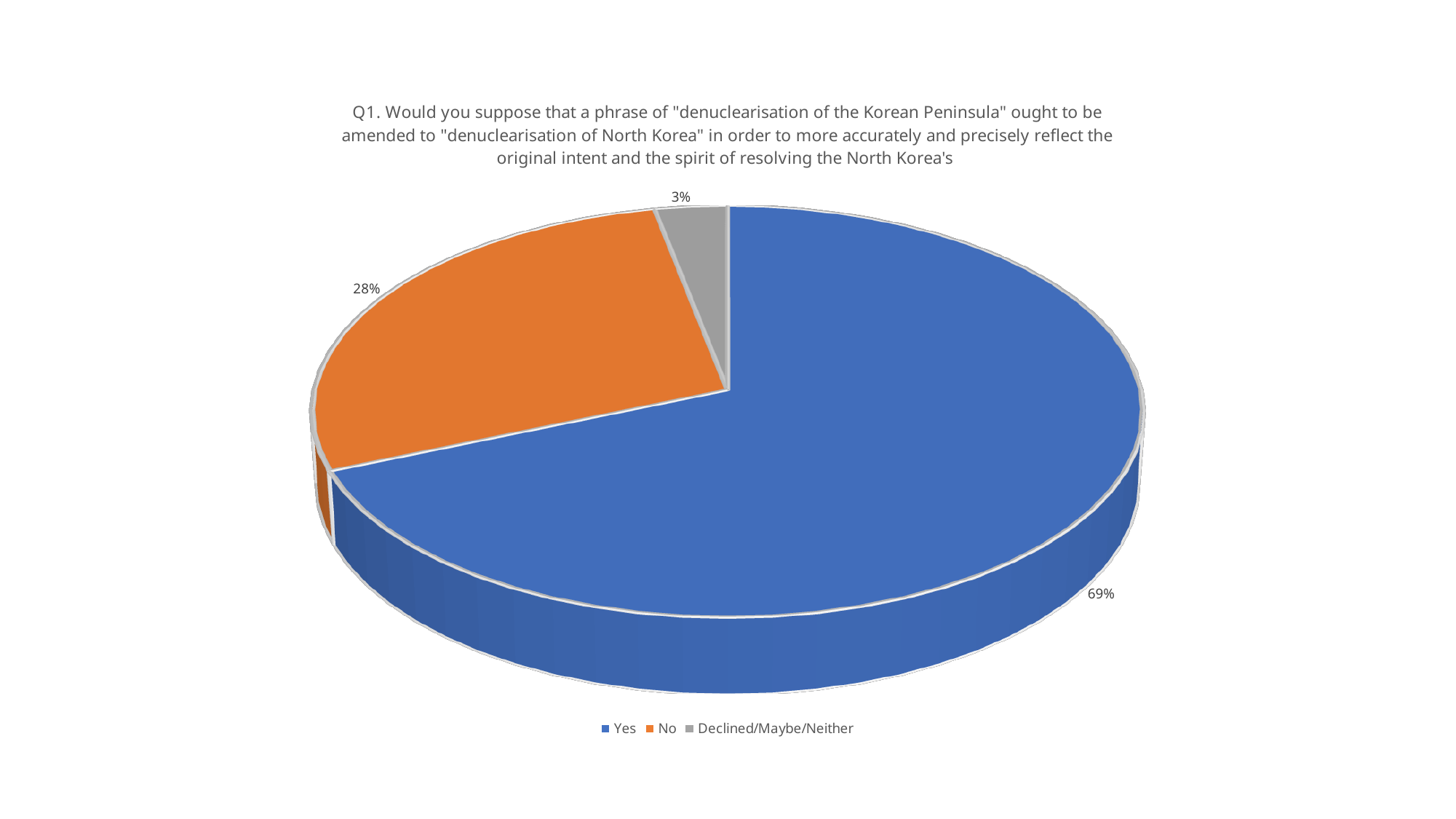
What share of respondents answered Yes? 69% Which response is shown in grey in the legend? Declined/Maybe/Neither What share of respondents answered Declined/Maybe/Neither? 3% What colour is the slice for No? Orange Which response has the smallest share of the pie? Declined/Maybe/Neither How many slices does the pie chart have? 3 What is the difference in percentage points between the No and Declined/Maybe/Neither shares? 25 Which is larger, the share for Yes or the share for No? Yes Which response has the largest share of the pie? Yes What is the difference in percentage points between the Yes and No shares? 41 What share of respondents answered No? 28% What kind of chart is shown on the slide? Pie chart